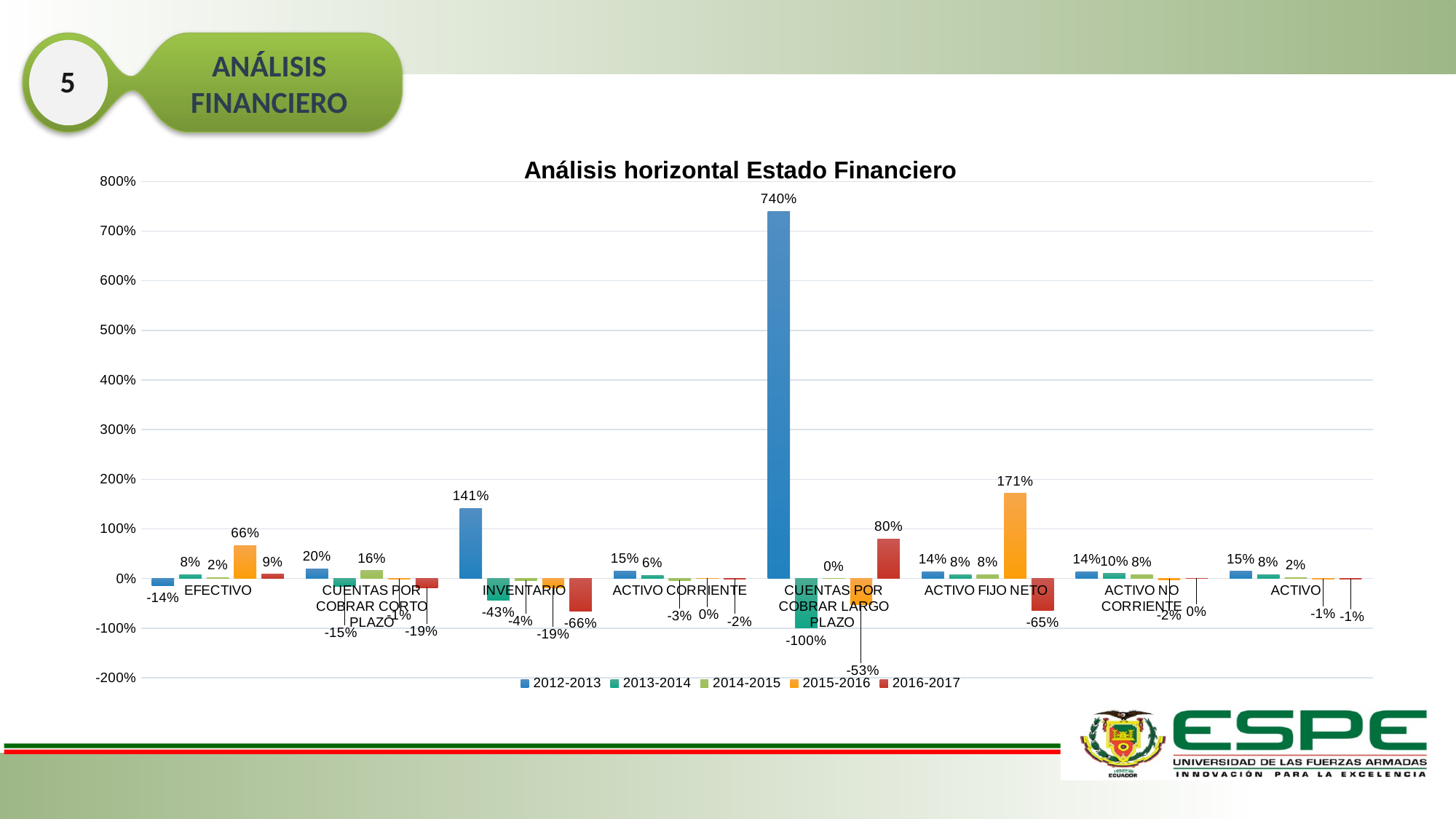
Which has the larger 2015-2016 value, EFECTIVO or ACTIVO FIJO NETO? ACTIVO FIJO NETO What is the 2015-2016 value for ACTIVO FIJO NETO? 171% What kind of chart is shown on the slide? bar chart What is the difference between the 2012-2013 values for CUENTAS POR COBRAR LARGO PLAZO and INVENTARIO? 599% How many categories are shown on the x axis? 8 Which category and series has the lowest value in the chart? CUENTAS POR COBRAR LARGO PLAZO, 2013-2014 How many series does the legend list? 5 What is the 2012-2013 value for INVENTARIO? 141% Which category and series has the highest value in the chart? CUENTAS POR COBRAR LARGO PLAZO, 2012-2013 What is the 2016-2017 value for INVENTARIO? -66% What is the 2012-2013 value for CUENTAS POR COBRAR LARGO PLAZO? 740% What is the title of the chart? Análisis horizontal Estado Financiero